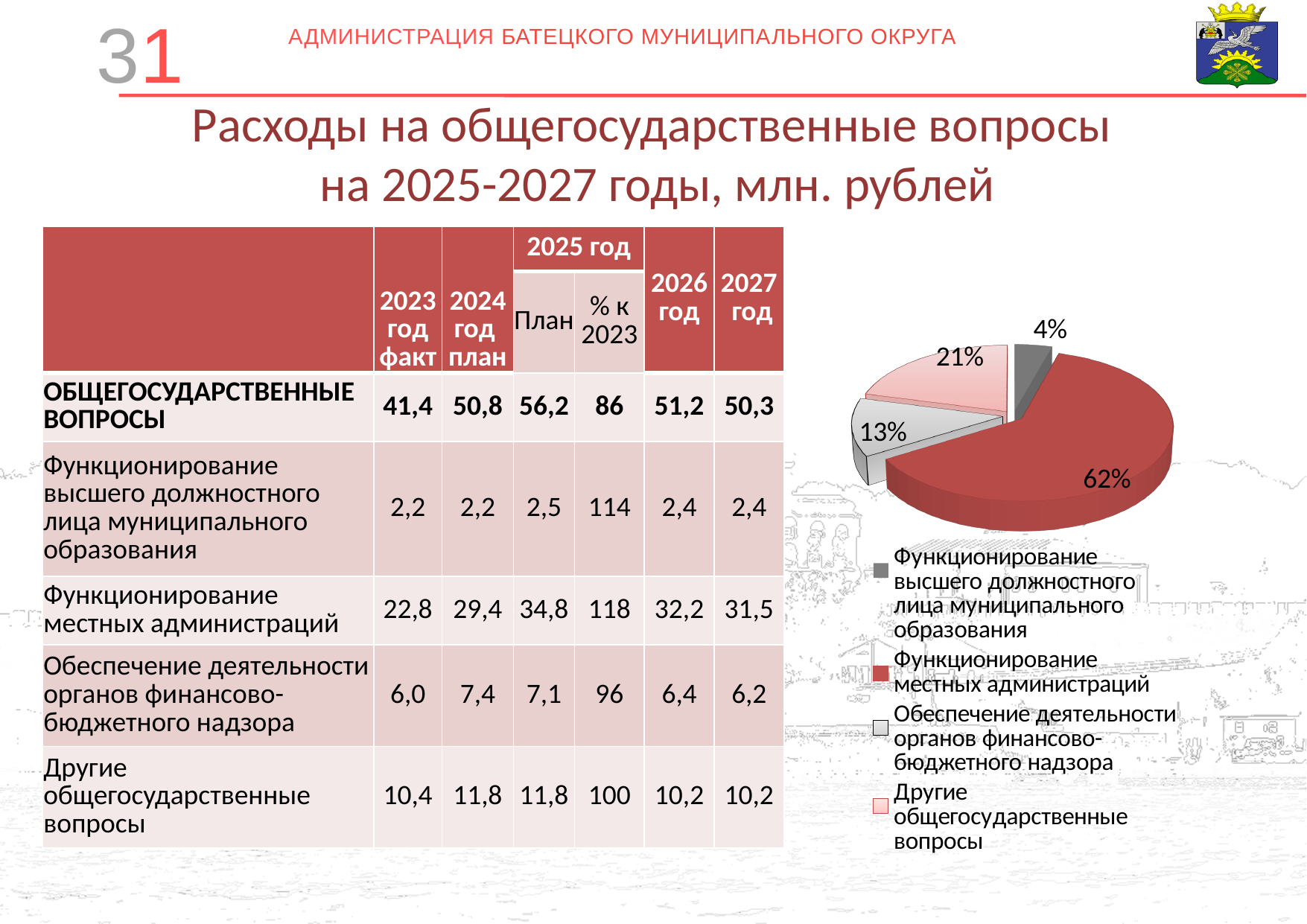
Which slice of the pie chart is the largest? Функционирование местных администраций Which is larger in the pie chart: the share for "Другие общегосударственные вопросы" or the share for "Обеспечение деятельности органов финансово-бюджетного надзора"? Другие общегосударственные вопросы How many slices does the pie chart have? 4 What is the difference in percentage points between the "Другие общегосударственные вопросы" slice and the "Обеспечение деятельности органов финансово-бюджетного надзора" slice? 8 What kind of chart is shown on the slide? pie chart What share of the pie does "Другие общегосударственные вопросы" have? 21% Which slice of the pie chart is the smallest? Функционирование высшего должностного лица муниципального образования What share of the pie does "Функционирование местных администраций" have? 62% What share of the pie does "Обеспечение деятельности органов финансово-бюджетного надзора" have? 13% What colour is the slice for "Функционирование местных администраций" in the pie chart? red How many entries does the pie chart legend list? 4